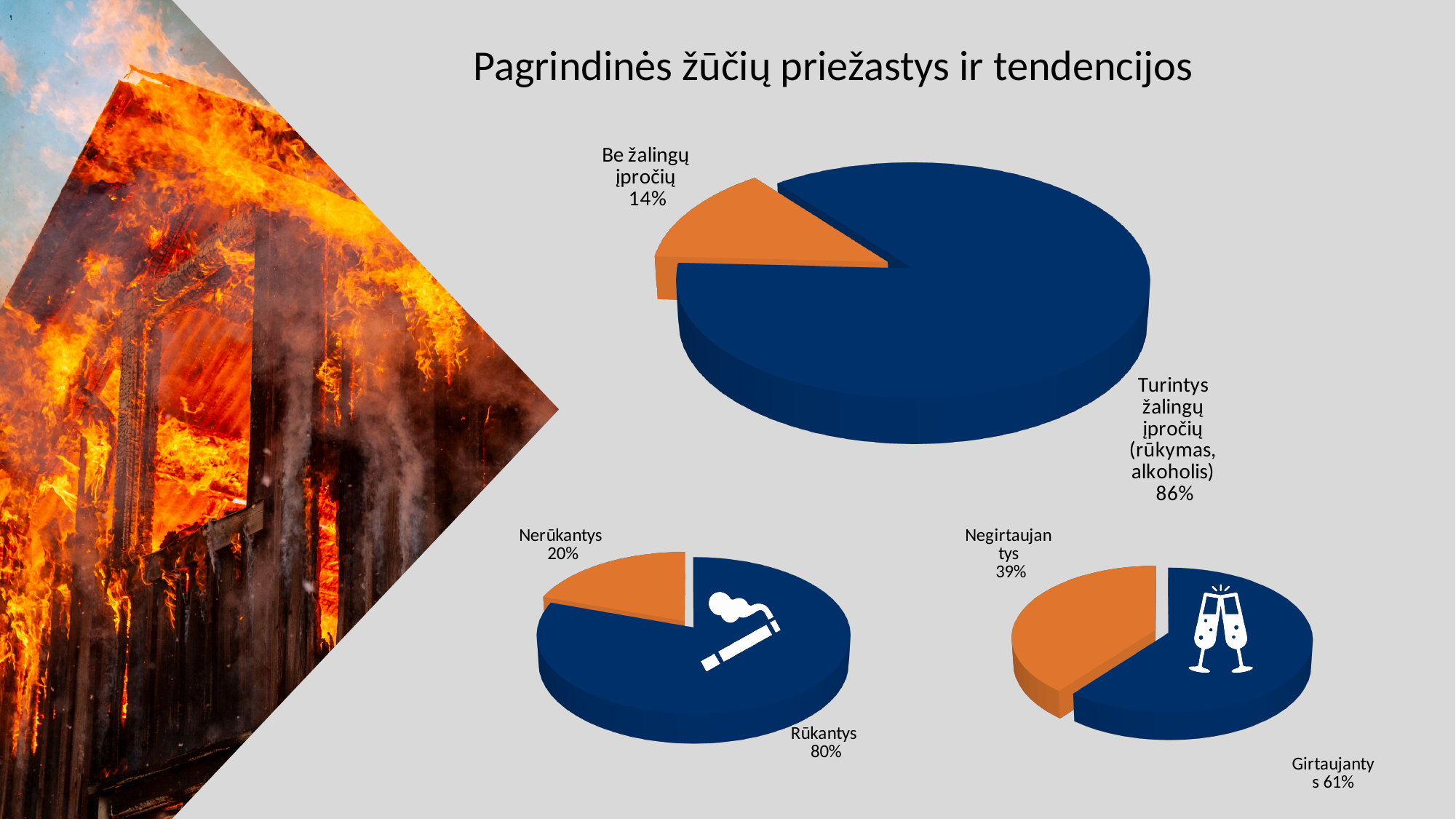
In the bottom-right pie chart, what share is labelled "Negirtaujantys"? 39% In the bottom-left pie chart, what share is labelled "Nerūkantys"? 20% How many pie charts are shown on the slide? 3 In the bottom-right pie chart, what share is labelled "Girtaujantys"? 61% In the bottom-left pie chart, which slice is the smallest? Nerūkantys In the bottom-left pie chart, what share is labelled "Rūkantys"? 80% In the top pie chart, which slice is the largest? Turintys žalingų įpročių (rūkymas, alkoholis) What type of chart is the top chart on the slide? Pie chart In the bottom-right pie chart, which is larger, Girtaujantys or Negirtaujantys? Girtaujantys In the top pie chart, what share is labelled "Turintys žalingų įpročių (rūkymas, alkoholis)"? 86% In the top pie chart, what is the difference in percentage points between the two slices? 72 In the top pie chart, what share is labelled "Be žalingų įpročių"? 14%